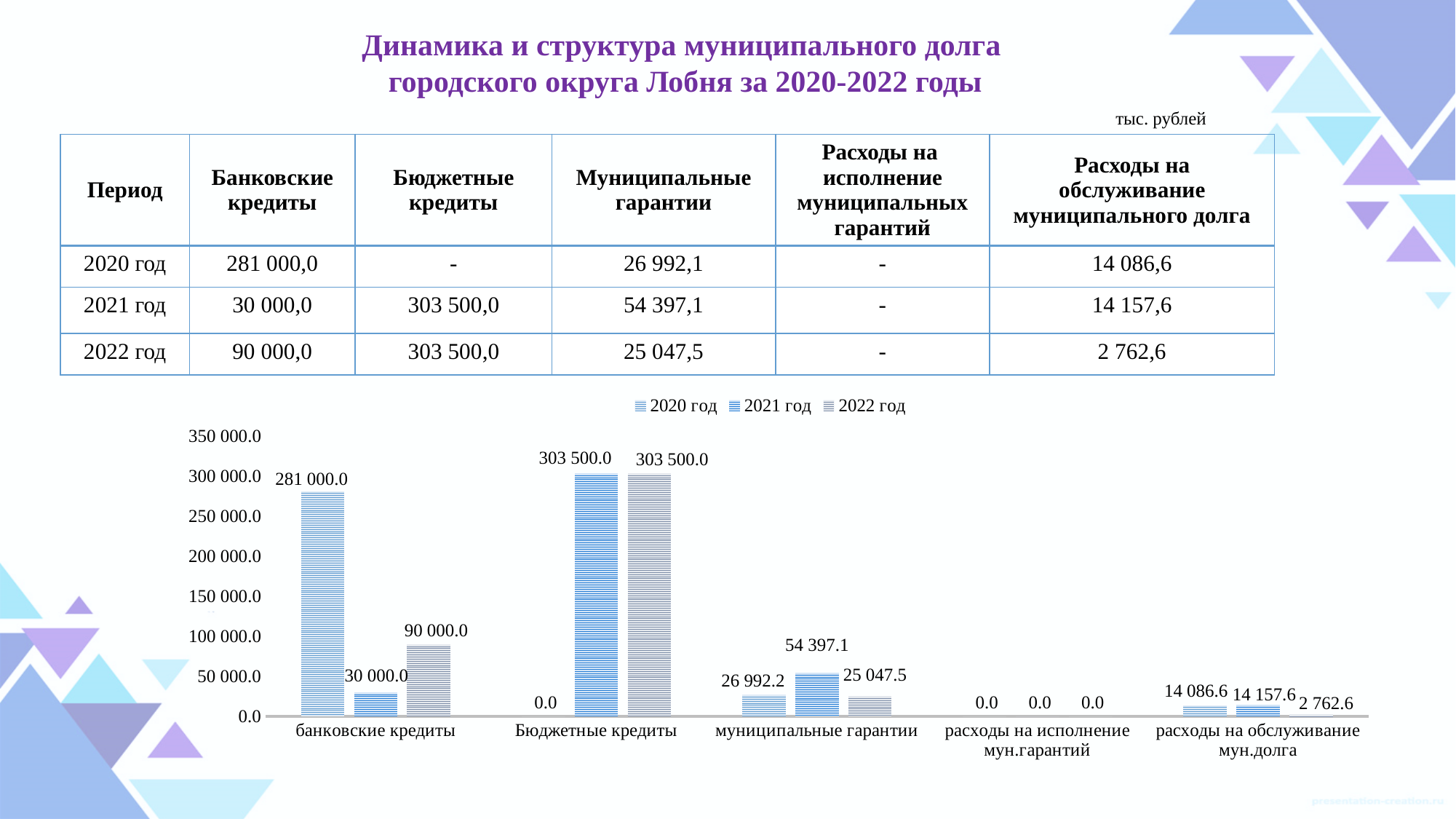
Which year has the lowest value for муниципальные гарантии on the chart? 2022 год Which is larger on the chart: муниципальные гарантии in 2020 год or in 2022 год? 2020 год How many categories are shown along the x axis of the chart? 5 What is the value for муниципальные гарантии in 2021 год on the chart? 54 397.1 What is the value for банковские кредиты in 2020 год on the chart? 281 000.0 How many series does the chart legend list? 3 What is the value for расходы на обслуживание мун.долга in 2022 год on the chart? 2 762.6 Is the value for Бюджетные кредиты in 2022 год greater or less than 300 000.0 on the chart? greater Which year has the highest value for банковские кредиты on the chart? 2020 год What is the difference between the 2022 год and 2021 год values for банковские кредиты on the chart? 60 000.0 What is the value for Бюджетные кредиты in 2021 год on the chart? 303 500.0 What kind of chart is shown on the slide? bar chart